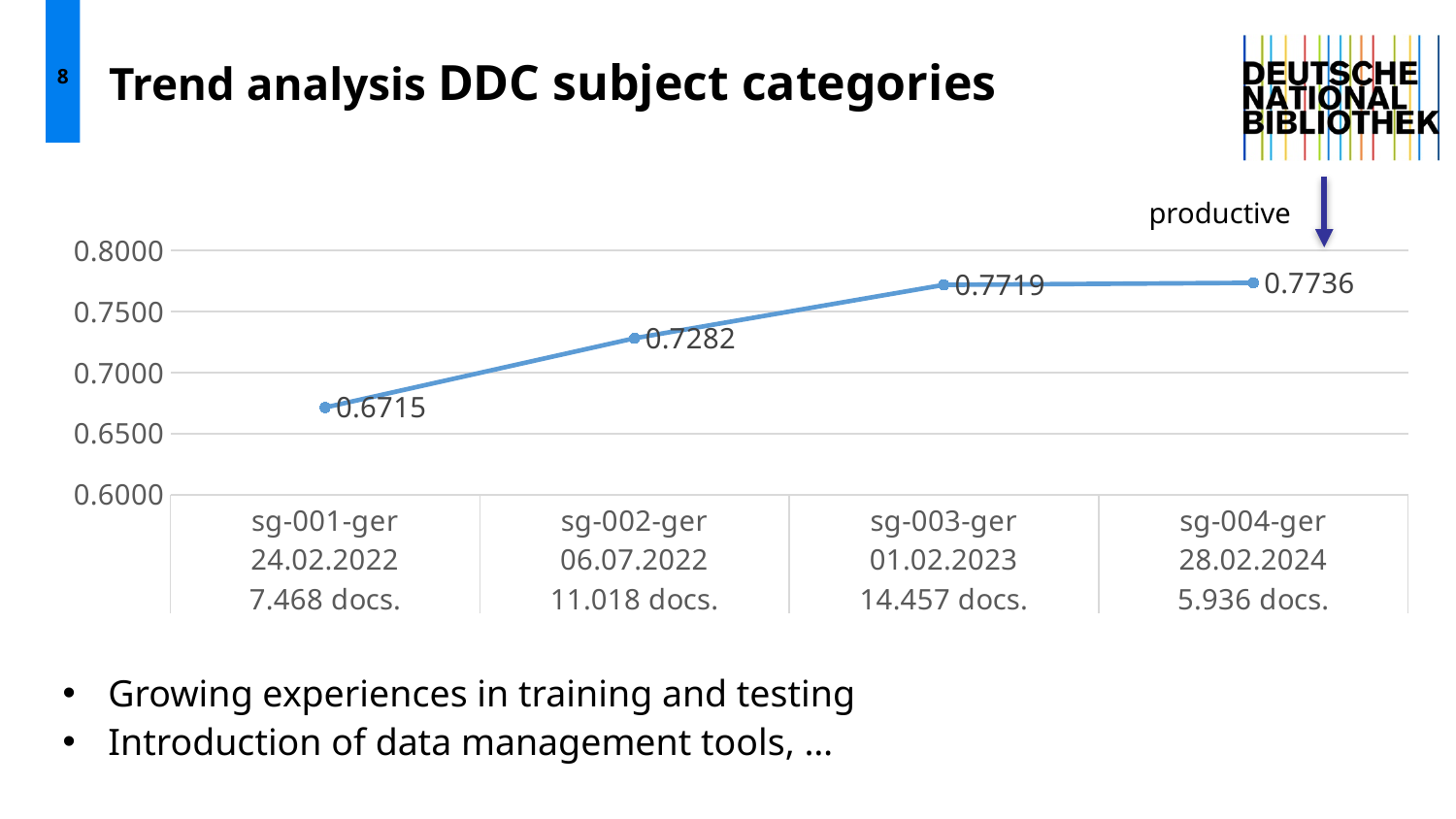
Which category has the lowest value? sg-001-ger What is the value for sg-003-ger? 0.7719 What is the value for sg-001-ger? 0.6715 Which is larger, the value for sg-002-ger or the value for sg-003-ger? sg-003-ger How many data points are plotted on the chart? 4 What is the difference between the values for sg-002-ger and sg-001-ger? 0.0567 Do the values rise or fall from sg-001-ger to sg-004-ger? rise Is the value for sg-002-ger greater or less than 0.7000? greater How many documents are listed for sg-003-ger on the x axis? 14.457 docs. What kind of chart is shown on the slide? line chart Which category has the highest value? sg-004-ger What is the value for sg-004-ger? 0.7736